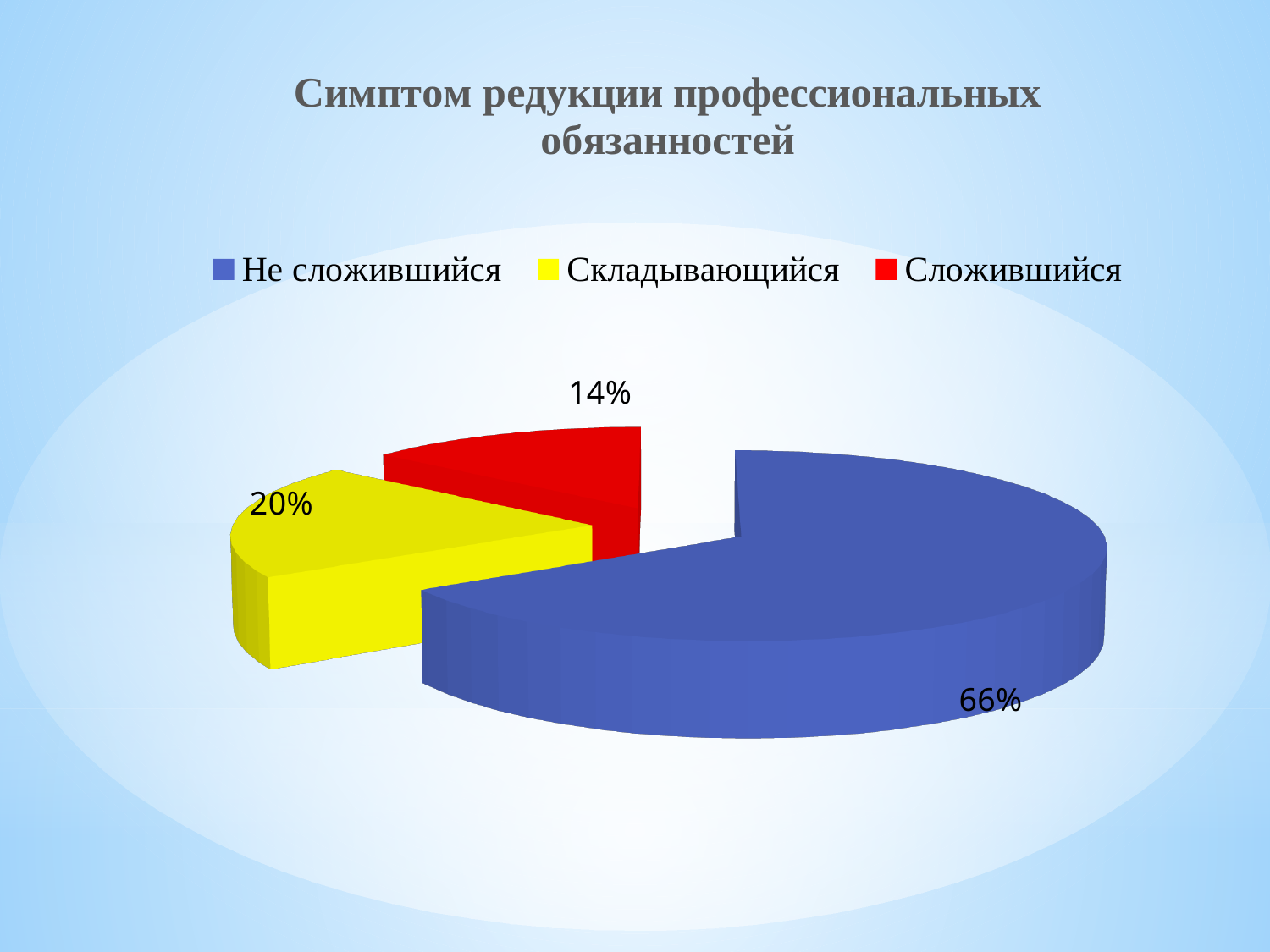
How many slices does the pie chart have? 3 What is the value for Складывающийся? 20% Which category has the smallest slice? Сложившийся What is the title of the chart? Симптом редукции профессиональных обязанностей What is the value for Сложившийся? 14% Which is larger, the slice for Складывающийся or the slice for Сложившийся? Складывающийся What is the difference between the values for Складывающийся and Сложившийся? 6% Which category has the largest slice? Не сложившийся What kind of chart is shown on the slide? pie chart What colour is the slice for Складывающийся? yellow What is the value for Не сложившийся? 66% What is the difference between the values for Не сложившийся and Складывающийся? 46%